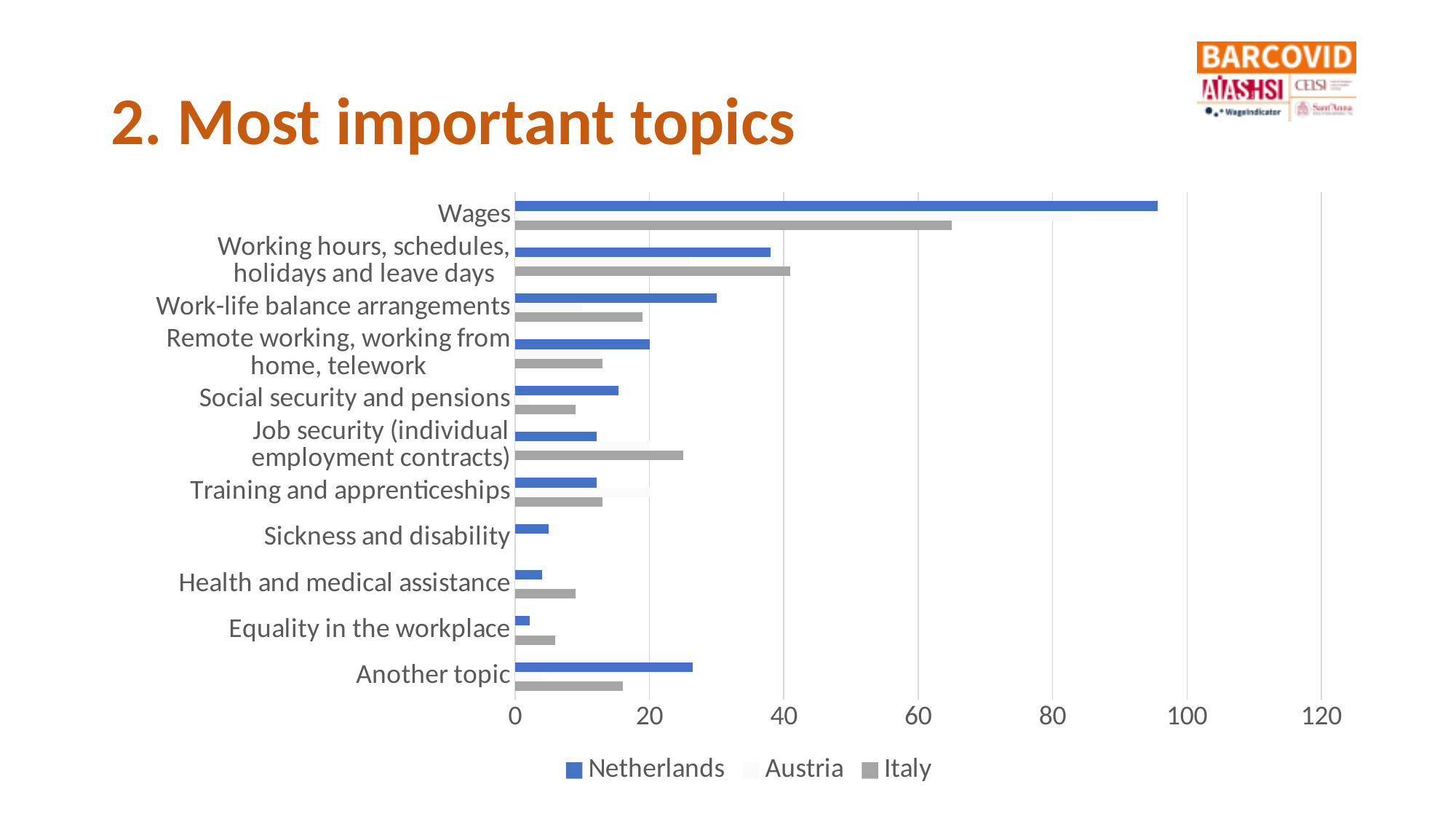
Which topic has the highest value for Netherlands? Wages Is the Netherlands value for Wages greater or less than 80? greater For Another topic, which is larger: the Netherlands value or the Italy value? Netherlands How many series does the legend list? 3 Is the Netherlands value for Work-life balance arrangements greater or less than 20? greater How many topic categories are shown on the chart? 11 Which topic has the highest value for Italy? Wages Is the Italy value for Wages greater or less than 60? greater What kind of chart is shown on the slide? bar chart For Job security (individual employment contracts), which is larger: the Netherlands value or the Italy value? Italy What is the title of the slide? 2. Most important topics